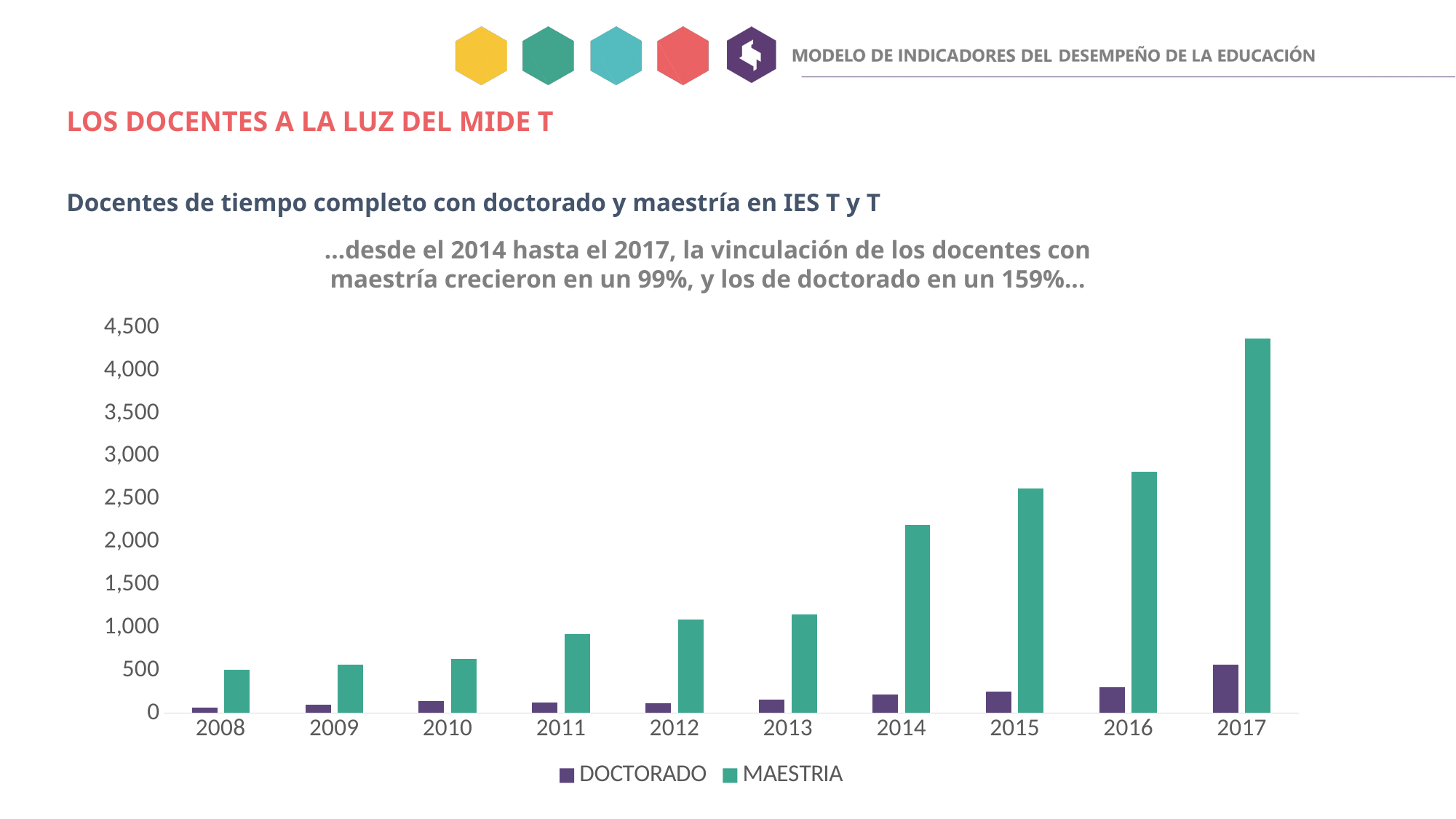
How many years are shown on the x axis? 10 Is the MAESTRIA value for 2014 greater or less than 2,000? greater What kind of chart is shown on the slide? bar chart What are the two series named in the legend? DOCTORADO and MAESTRIA Which year has the larger MAESTRIA value, 2014 or 2015? 2015 Do the MAESTRIA values generally rise or fall from 2008 to 2017? rise In which year is the DOCTORADO value highest? 2017 Is the MAESTRIA value for 2016 greater or less than 3,000? less In which year is the MAESTRIA value highest? 2017 Is the MAESTRIA value for 2017 greater or less than 4,000? greater In which year is the MAESTRIA value lowest? 2008 How many series does the legend list? 2